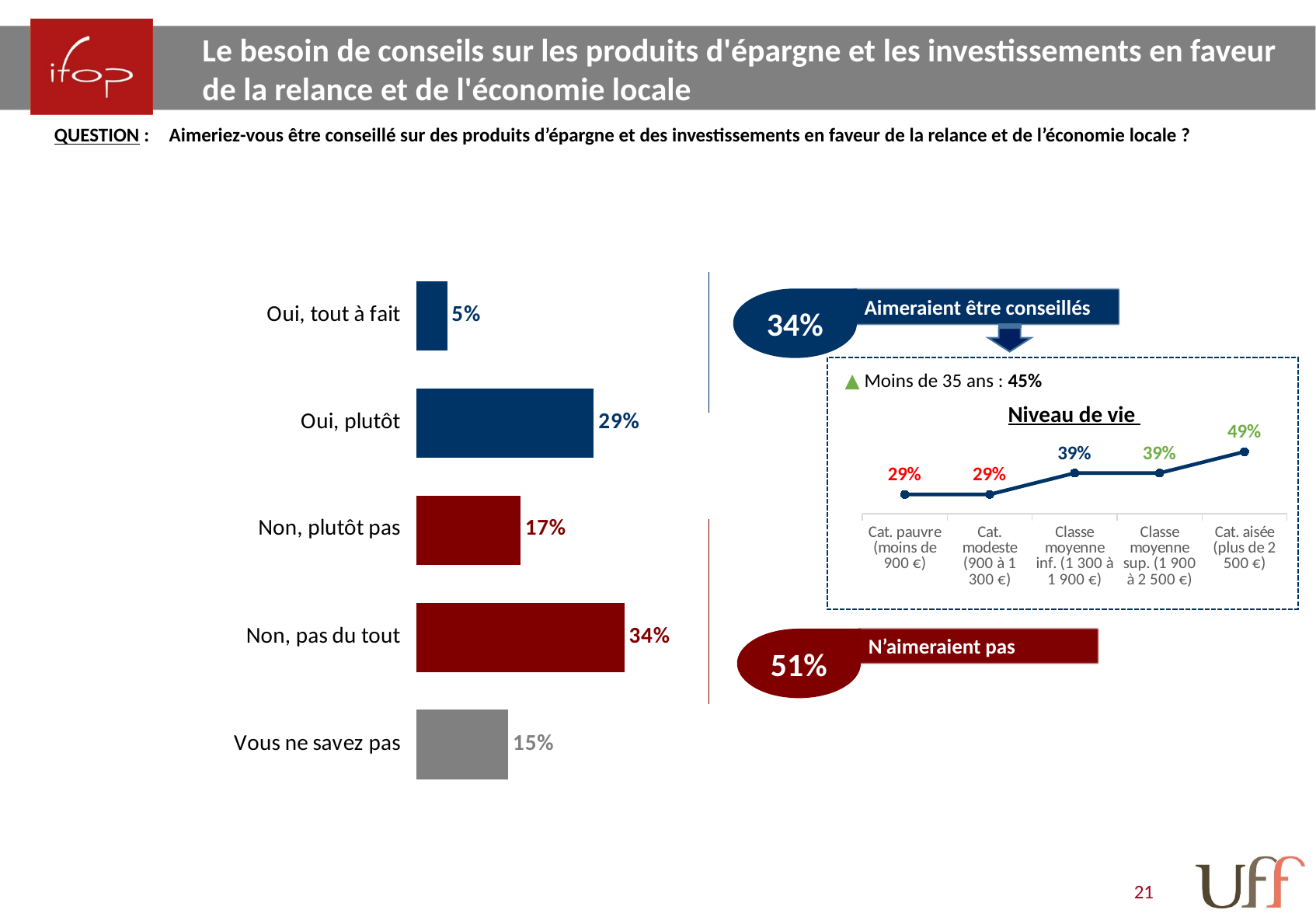
In the bar chart on the left, which is larger: "Oui, plutôt" or "Non, plutôt pas"? Oui, plutôt In the bar chart on the left, which category has the highest value? Non, pas du tout What kind of chart is the "Niveau de vie" chart? Line chart In the bar chart on the left, which category has the lowest value? Oui, tout à fait In the bar chart on the left, what is the value for "Vous ne savez pas"? 15% In the "Niveau de vie" chart, do the values rise or fall from left to right? Rise In the "Niveau de vie" chart, what is the value for "Cat. modeste (900 à 1 300 €)"? 29% How many categories does the bar chart on the left show? 5 In the bar chart on the left, what is the difference between "Non, pas du tout" and "Non, plutôt pas"? 17% In the bar chart on the left, what is the value for "Oui, plutôt"? 29% In the "Niveau de vie" chart, what is the value for "Cat. aisée (plus de 2 500 €)"? 49% What kind of chart is the chart on the left of the slide? Bar chart